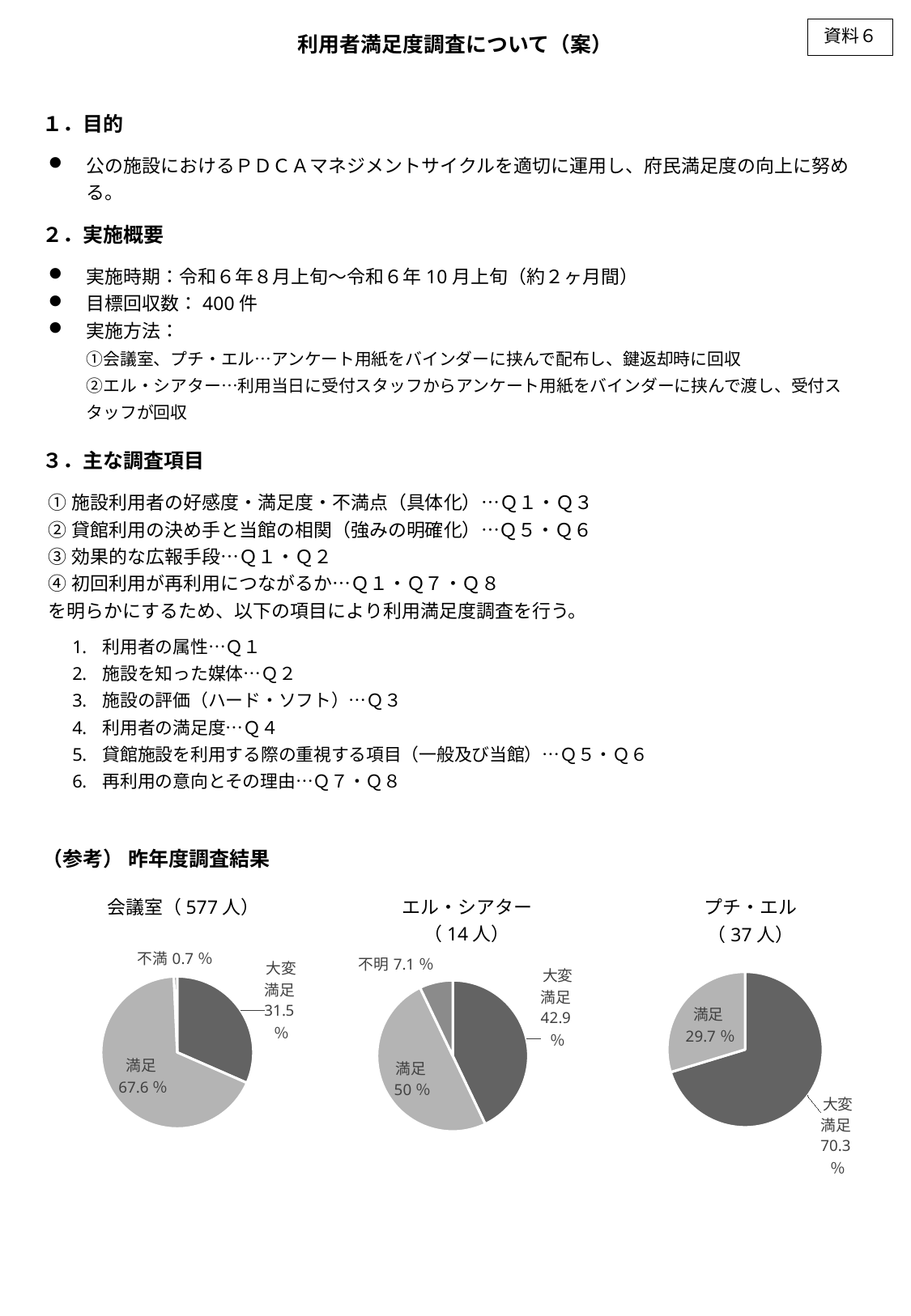
「エル・シアター（14人）」の円グラフで、最も割合が大きい項目はどれですか？ 満足 「エル・シアター（14人）」の円グラフには、いくつの項目がありますか？ 3 「会議室（577人）」の円グラフで、「満足」の割合はいくつですか？ 67.6 % このスライドの「（参考）昨年度調査結果」に示されているグラフの種類は何ですか？ 円グラフ 「プチ・エル（37人）」の円グラフで、「大変満足」と「満足」の差は何ポイントですか？ 40.6 % 「会議室（577人）」の円グラフで、「大変満足」の割合はいくつですか？ 31.5 % 「プチ・エル（37人）」の円グラフで、「大変満足」の割合はいくつですか？ 70.3 % 「エル・シアター（14人）」の円グラフで、「不明」の割合はいくつですか？ 7.1 % 「エル・シアター（14人）」の円グラフで、「大変満足」と「満足」ではどちらの割合が大きいですか？ 満足 「会議室（577人）」の円グラフで、「満足」と「大変満足」の差は何ポイントですか？ 36.1 % 「プチ・エル（37人）」の円グラフで、「満足」の割合はいくつですか？ 29.7 % 「会議室（577人）」の円グラフで、最も割合が小さい項目はどれですか？ 不満